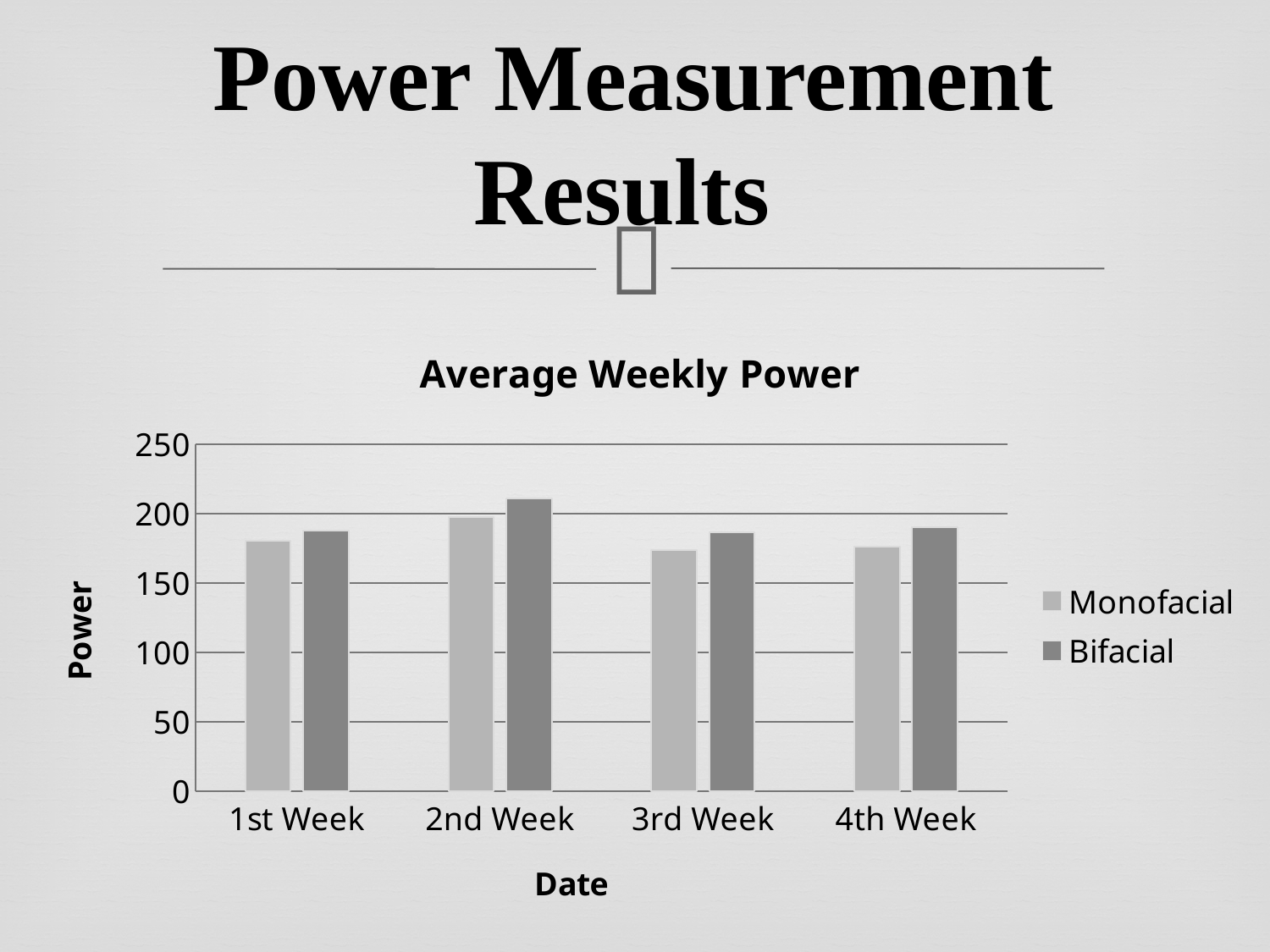
How many series does the legend list? 2 How many week categories are shown on the x axis? 4 Is the Monofacial value for the 1st Week greater or less than 150? greater Is the Monofacial value for the 3rd Week greater or less than 200? less In the 3rd Week, which is larger, Monofacial or Bifacial? Bifacial What kind of chart is shown on the slide? bar chart Does the Bifacial value rise or fall from the 2nd Week to the 3rd Week? fall What is the title of the chart? Average Weekly Power Is the Bifacial value for the 2nd Week greater or less than 200? greater Which week has the highest Bifacial value? 2nd Week Which week has the highest Monofacial value? 2nd Week In the 2nd Week, which is larger, Monofacial or Bifacial? Bifacial